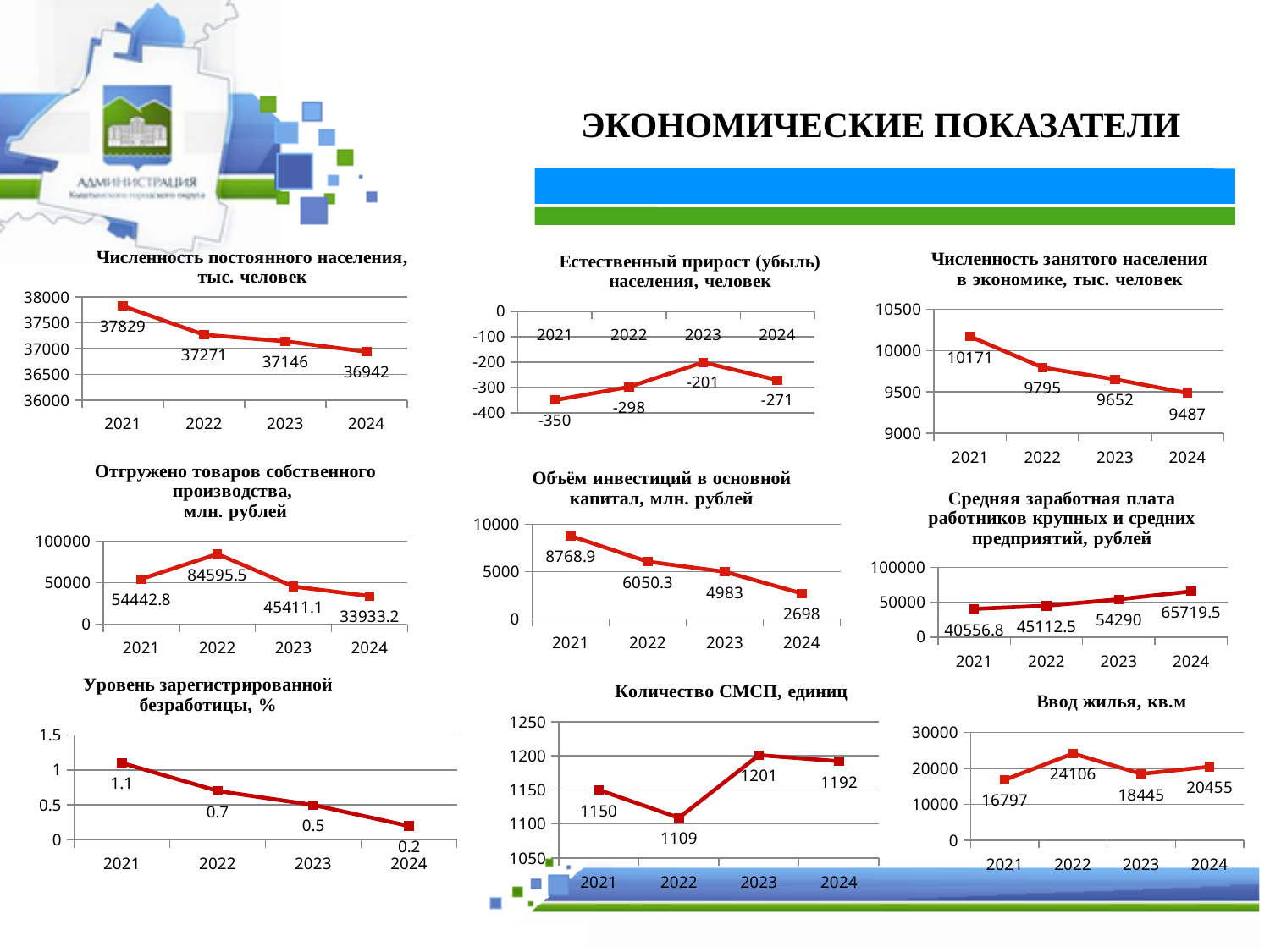
In the chart "Объём инвестиций в основной капитал, млн. рублей", do the values rise or fall from 2021 to 2024? fall What type of chart is "Ввод жилья, кв.м"? line chart In the chart "Отгружено товаров собственного производства, млн. рублей", which year has the highest value? 2022 In the chart "Численность постоянного населения, тыс. человек", what is the value for 2024? 36942 In the chart "Средняя заработная плата работников крупных и средних предприятий, рублей", what is the value for 2023? 54290 How many charts are shown on the slide? 9 How many data points are plotted in the chart "Естественный прирост (убыль) населения, человек"? 4 In the chart "Численность занятого населения в экономике, тыс. человек", what is the difference between the 2021 and 2024 values? 684 In the chart "Уровень зарегистрированной безработицы, %", what is the value for 2022? 0.7 In the chart "Ввод жилья, кв.м", what is the difference between the 2022 and 2021 values? 7309 In the chart "Естественный прирост (убыль) населения, человек", which year has the lowest value? 2021 In the chart "Количество СМСП, единиц", which is larger, the value for 2021 or the value for 2022? 2021